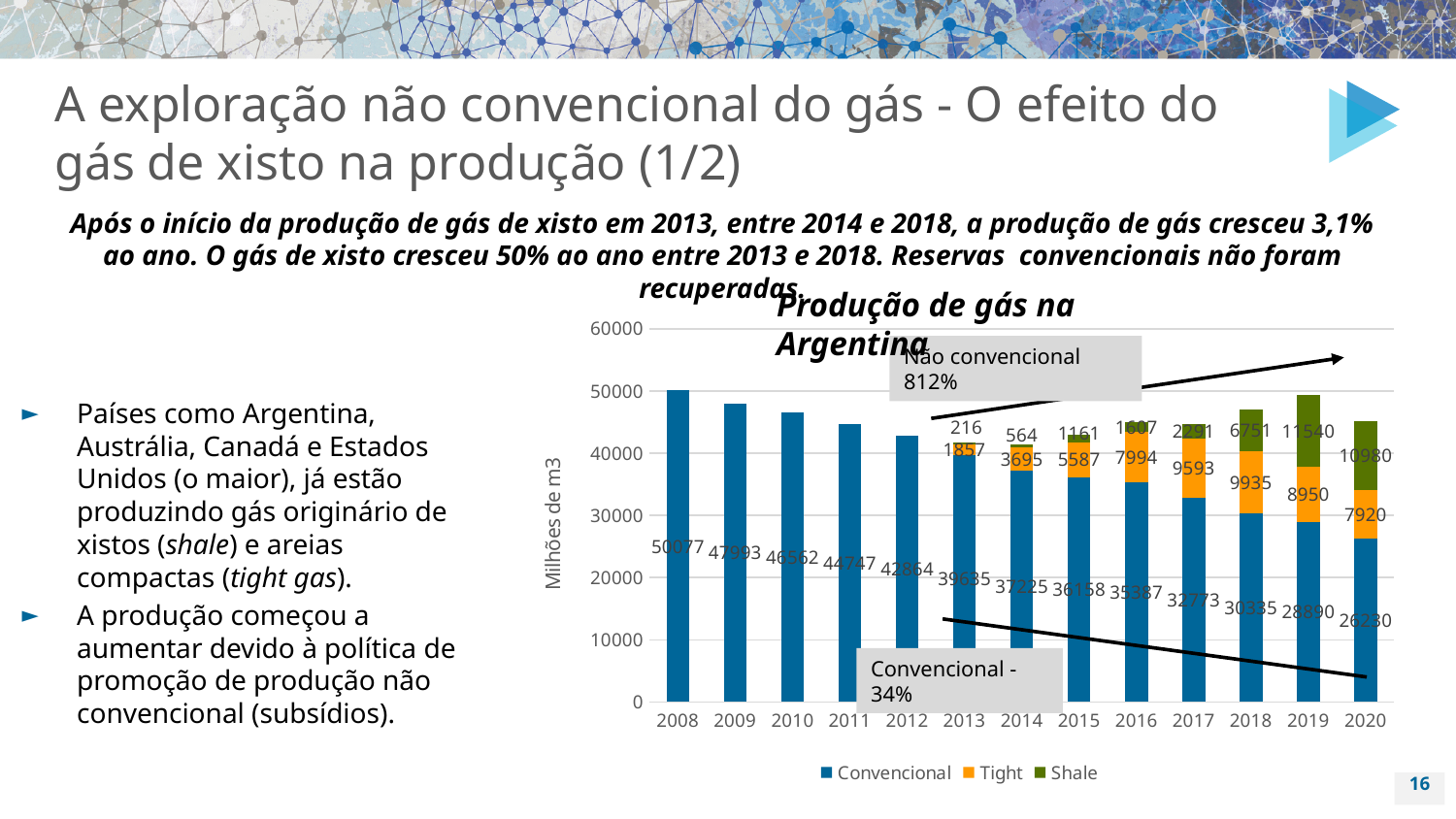
What is the Tight value for 2018? 9935 How many series does the legend of the chart list? 3 What is the Convencional value for 2008? 50077 What is the difference between the Convencional values for 2008 and 2020? 23847 What is the Convencional value for 2020? 26230 What kind of chart is shown on the slide? Stacked bar chart Does the Convencional series rise or fall from 2008 to 2020? Fall What is the Shale value for 2019? 11540 In which year is the Convencional value lowest? 2020 In which year is the Convencional value highest? 2008 How many years are shown on the x axis of the chart? 13 What is the total of the stacked bar for 2020? 45130